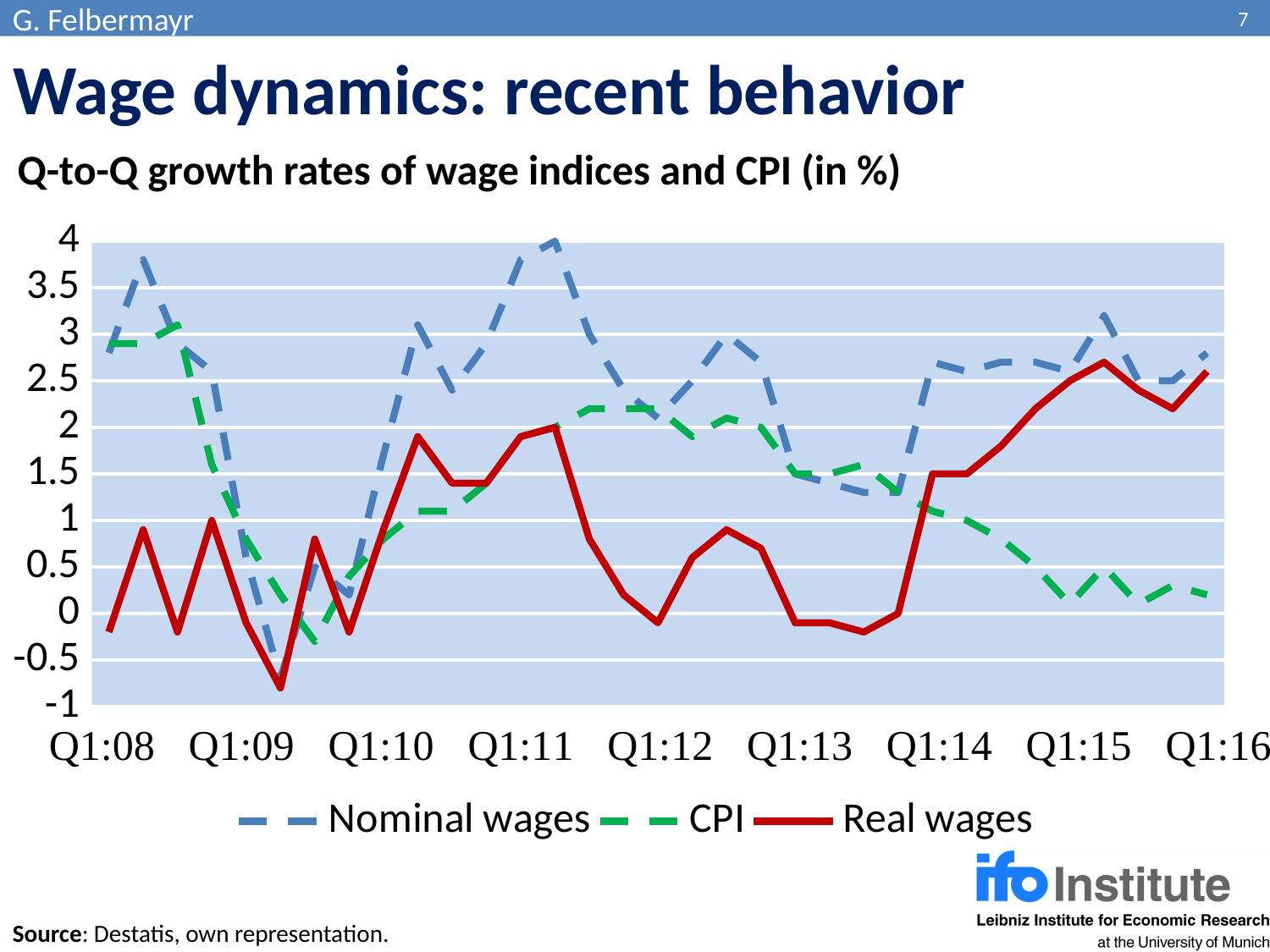
Is the value for CPI at Q1:16 greater or less than 1? less At Q1:08, which is larger: Nominal wages or Real wages? Nominal wages Is the value for Nominal wages at Q1:08 greater or less than 2? greater At Q1:16, which is larger: Real wages or CPI? Real wages How many series does the legend list? 3 Is the value for Real wages at Q1:16 greater or less than 2? greater What are the three series listed in the legend? Nominal wages, CPI, Real wages How many quarter labels are shown on the x axis? 9 Which series reaches the highest value anywhere on the chart? Nominal wages What is the subtitle describing the chart's content? Q-to-Q growth rates of wage indices and CPI (in %) What kind of chart is shown on the slide? line chart